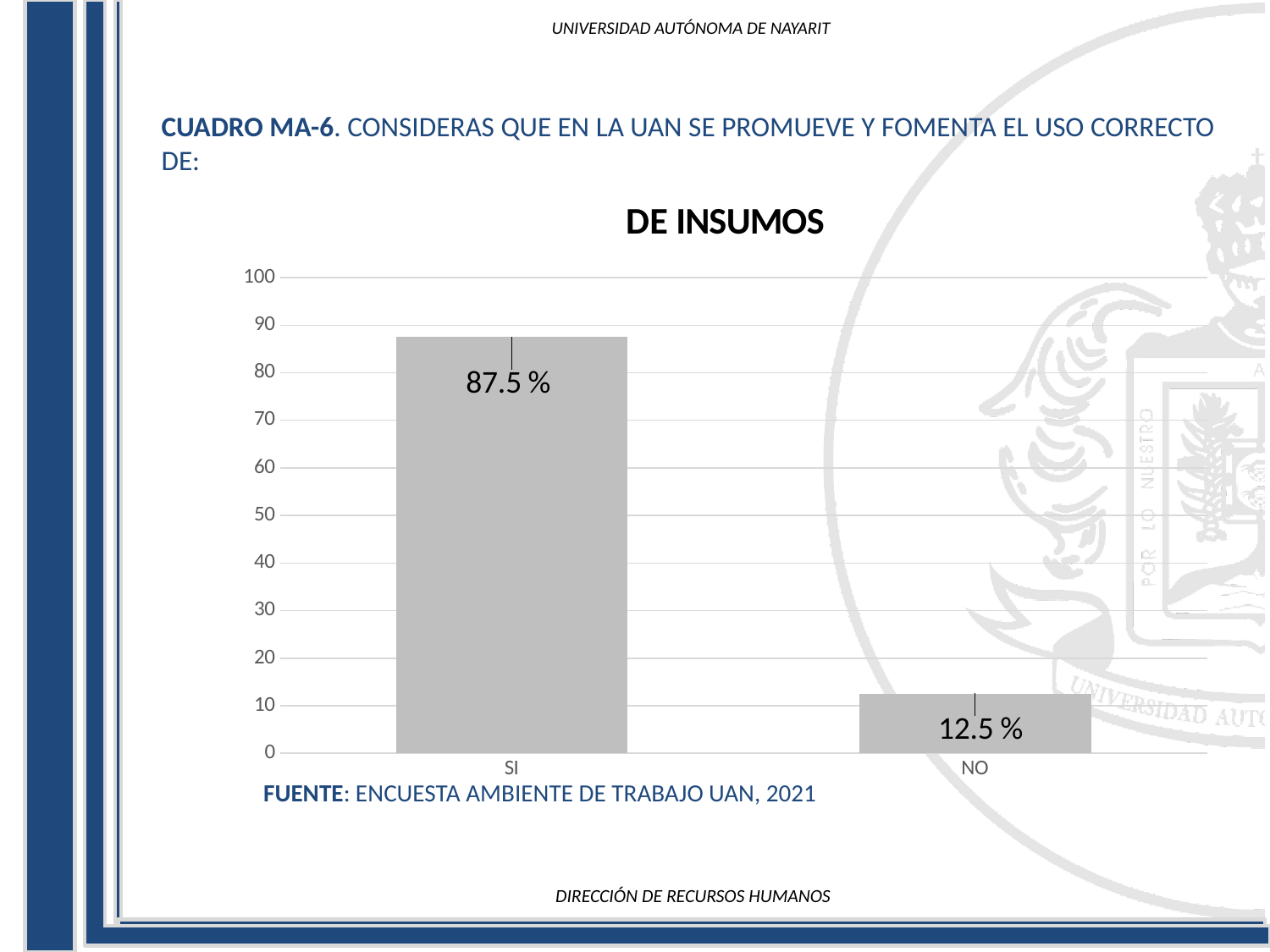
How many categories are shown on the x axis? 2 Which category has the highest value? SI What is the difference between the values for SI and NO? 75 % What is the source cited below the chart? ENCUESTA AMBIENTE DE TRABAJO UAN, 2021 What is the value for NO? 12.5 % What kind of chart is shown? bar chart What is the value for SI? 87.5 % Which is larger, the value for SI or the value for NO? SI Is the value for SI greater or less than 80? greater Is the value for NO greater or less than 20? less Which category has the lowest value? NO What is the title of the chart? DE INSUMOS